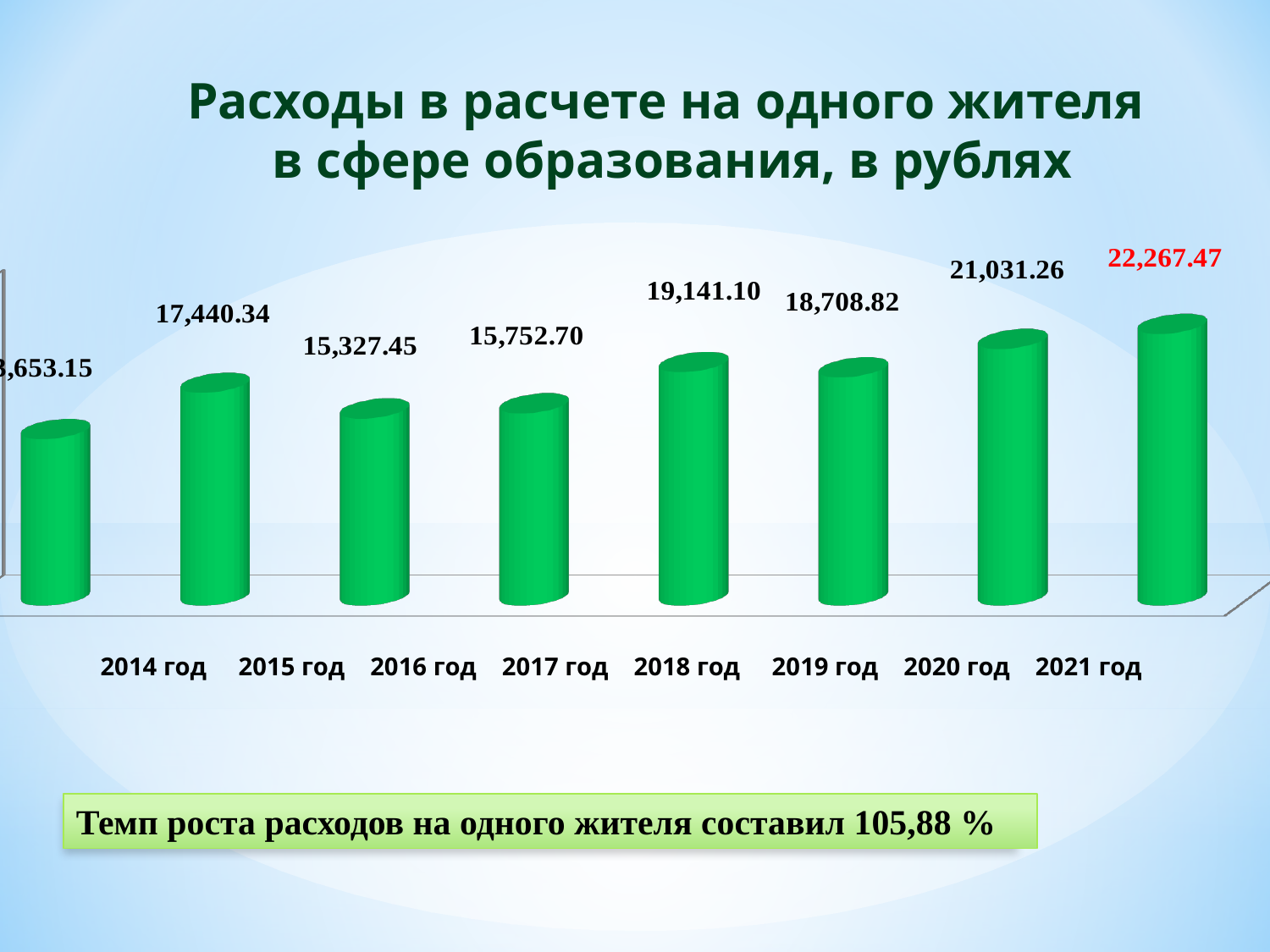
What is the value for 2016 год? 15,327.45 What is the value for 2020 год? 21,031.26 What growth rate of expenses per resident is stated in the text box below the chart? 105,88 % Which year has the lowest value? 2014 год What is the difference between the values for 2021 год and 2020 год? 1,236.21 What is the value for 2021 год? 22,267.47 What kind of chart is shown on the slide? Bar chart Which year has the highest value? 2021 год What is the value for 2018 год? 19,141.10 Which is larger, the value for 2015 год or the value for 2017 год? 2015 год How many years are shown on the chart? 8 What is the difference between the values for 2018 год and 2019 год? 432.28